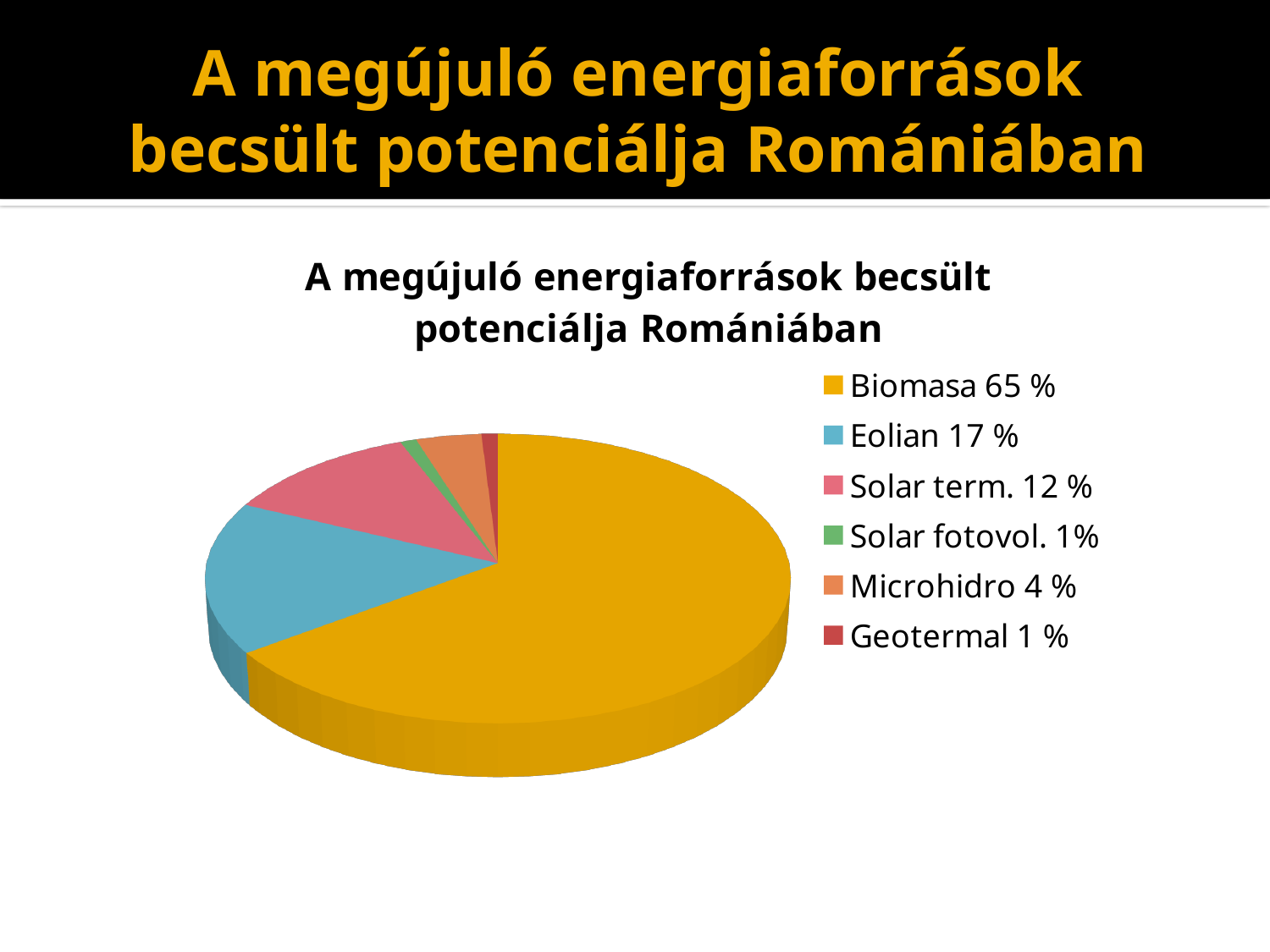
What kind of chart is shown on the slide? pie chart What colour is the Biomasa slice in the pie chart? yellow/orange What percentage is shown for Microhidro in the legend? 4 % What is the difference in percentage points between Biomasa and Eolian? 48 What is the difference in percentage points between Microhidro and Geotermal? 3 What share of the pie does Biomasa account for? 65 % What percentage is shown for Eolian in the legend? 17 % How many categories does the legend list? 6 What percentage is shown for Solar term. in the legend? 12 % Which is larger, the share for Eolian or the share for Solar term.? Eolian Which category has the largest slice of the pie? Biomasa What percentage is shown for Solar fotovol. in the legend? 1%